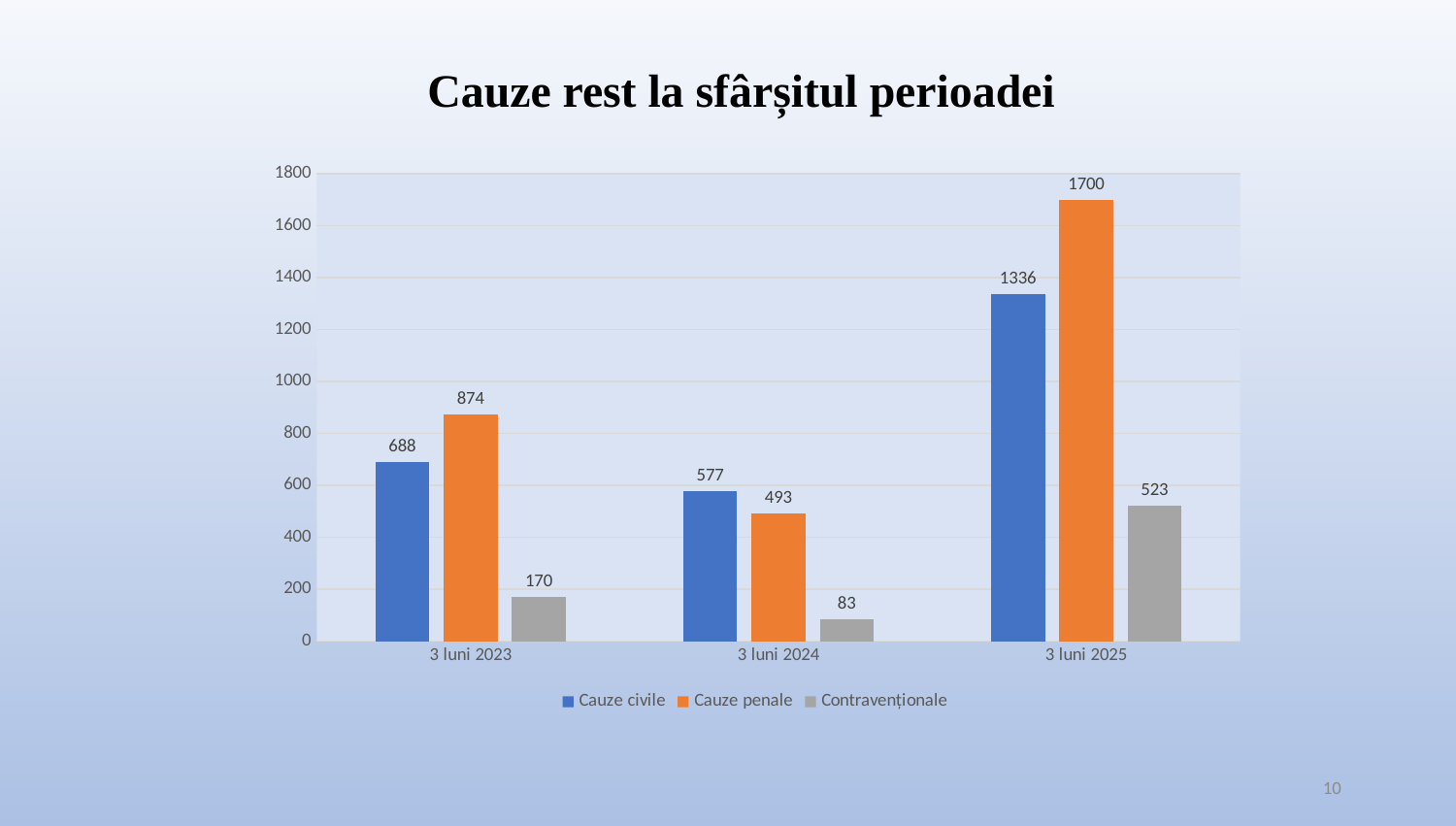
Which is larger in 3 luni 2024: Cauze civile or Cauze penale? Cauze civile How many periods are shown on the x axis? 3 What is the difference between Cauze penale and Cauze civile in 3 luni 2025? 364 What is the title of the chart? Cauze rest la sfârșitul perioadei What is the value for Cauze penale in 3 luni 2025? 1700 What is the value for Contravenționale in 3 luni 2024? 83 What kind of chart is shown on the slide? Bar chart What is the value for Cauze civile in 3 luni 2023? 688 Is the value for Cauze penale in 3 luni 2023 greater or less than 800? greater In which period is the value for Cauze civile highest? 3 luni 2025 How many series does the legend list? 3 In which period is the value for Contravenționale lowest? 3 luni 2024